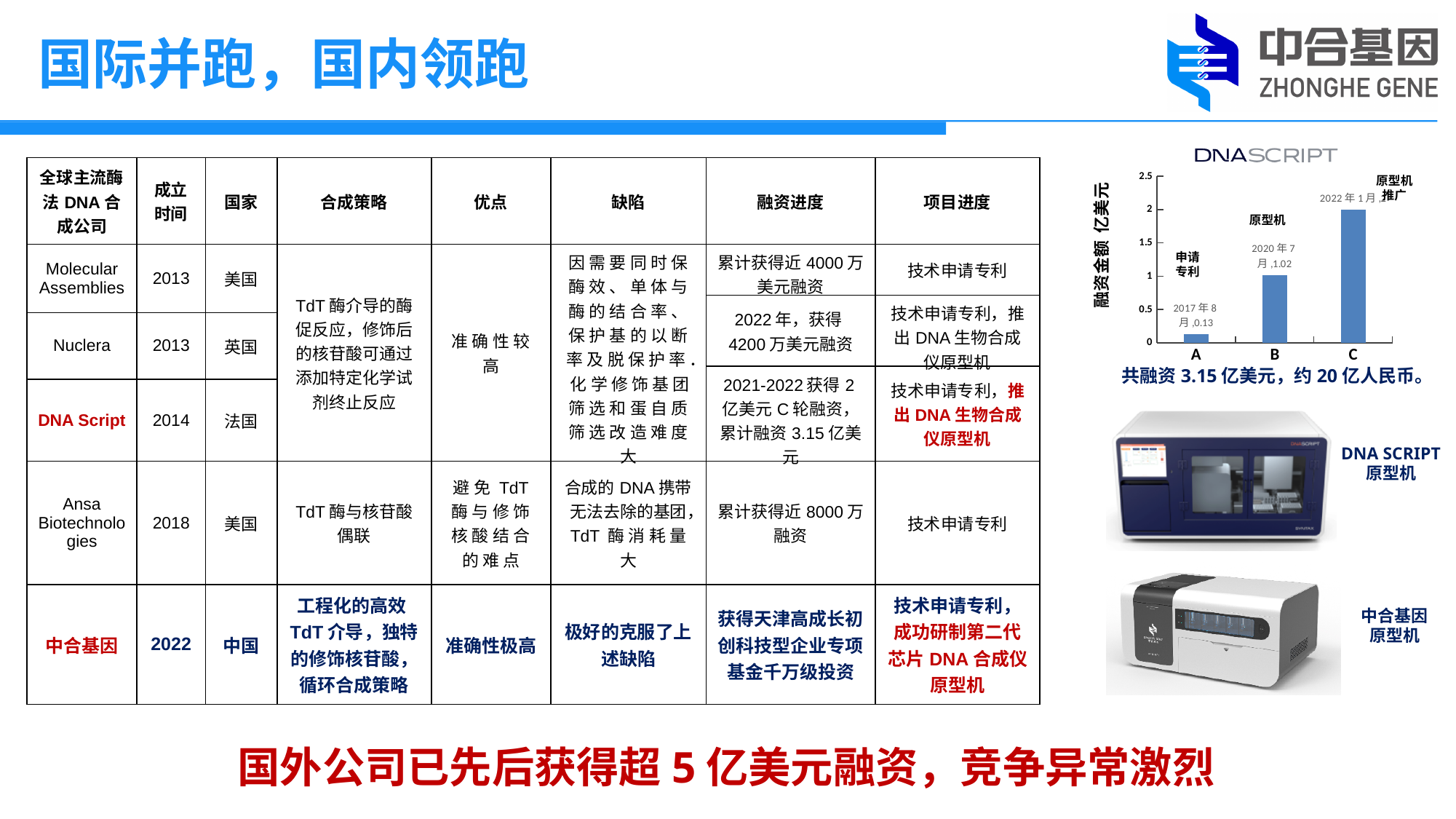
In the DNASCRIPT bar chart, what is the value for category A? 0.13 How many categories are shown on the x axis of the DNASCRIPT bar chart? 3 In the DNASCRIPT bar chart, is the value for A greater or less than 0.5? less In the DNASCRIPT bar chart, what is the value for category B? 1.02 In the DNASCRIPT bar chart, what is the difference between the values for B and A? 0.89 In the DNASCRIPT bar chart, is the value for C greater or less than 1.5? greater What kind of chart is the DNASCRIPT chart on the right of the slide? bar chart In the DNASCRIPT bar chart, which category has the lowest value? A In the DNASCRIPT bar chart, which category has the highest value? C In the DNASCRIPT bar chart, which is larger, the value for B or the value for C? C What is the y-axis label of the DNASCRIPT bar chart? 融资金额 亿美元 In the DNASCRIPT bar chart, do the values rise or fall from A to C? rise